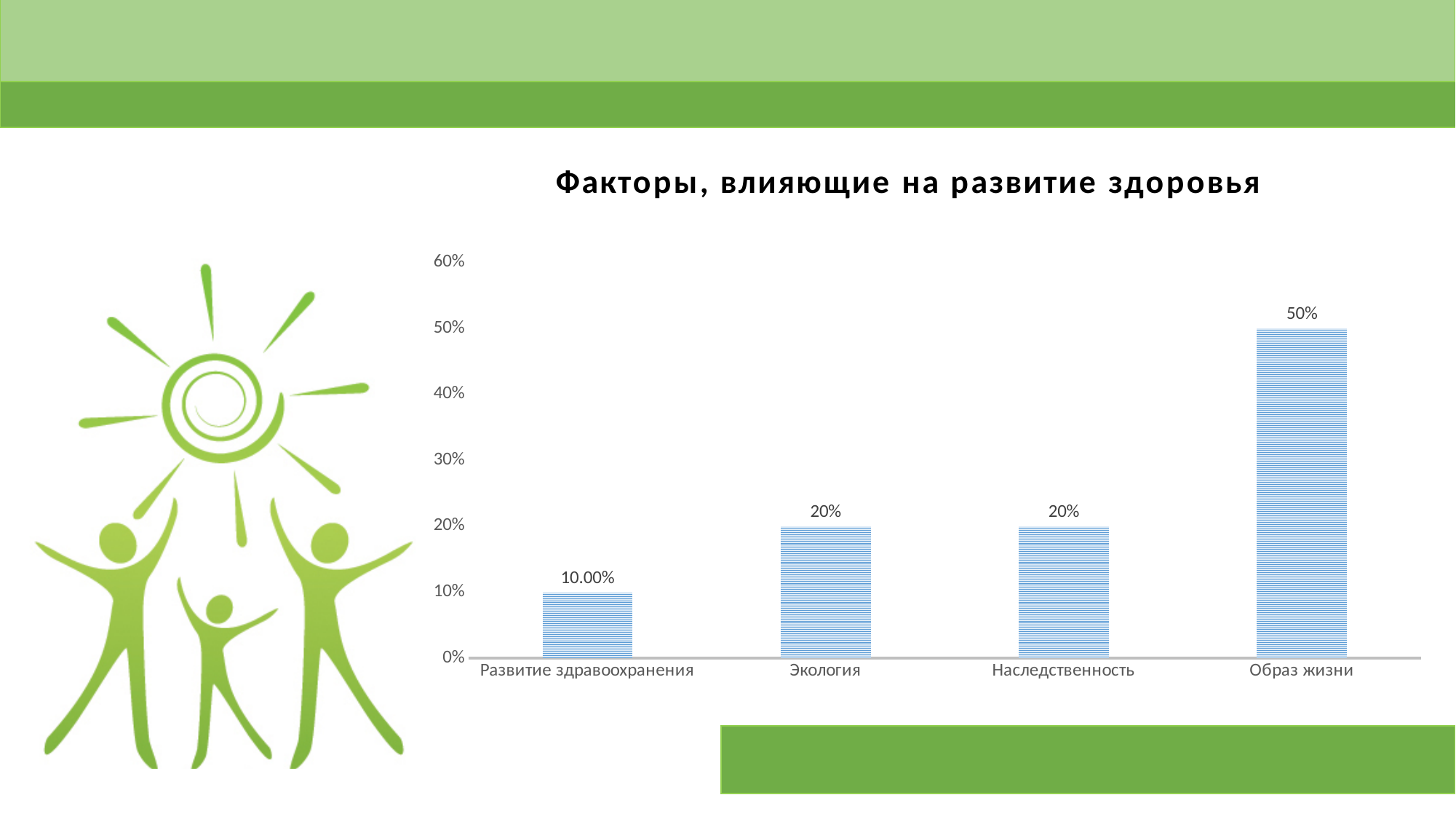
What is the difference between the values for Образ жизни and Наследственность? 30% How many categories are shown on the x axis? 4 What is the value for Образ жизни? 50% Which category has the lowest value? Развитие здравоохранения Which category has the highest value? Образ жизни Is the value for Образ жизни greater or less than 40%? greater Which is larger, the value for Экология or the value for Развитие здравоохранения? Экология What kind of chart is shown on the slide? bar chart What is the title of the chart? Факторы, влияющие на развитие здоровья What is the value for Развитие здравоохранения? 10.00% What is the highest value shown on the vertical axis? 60% What is the value for Экология? 20%